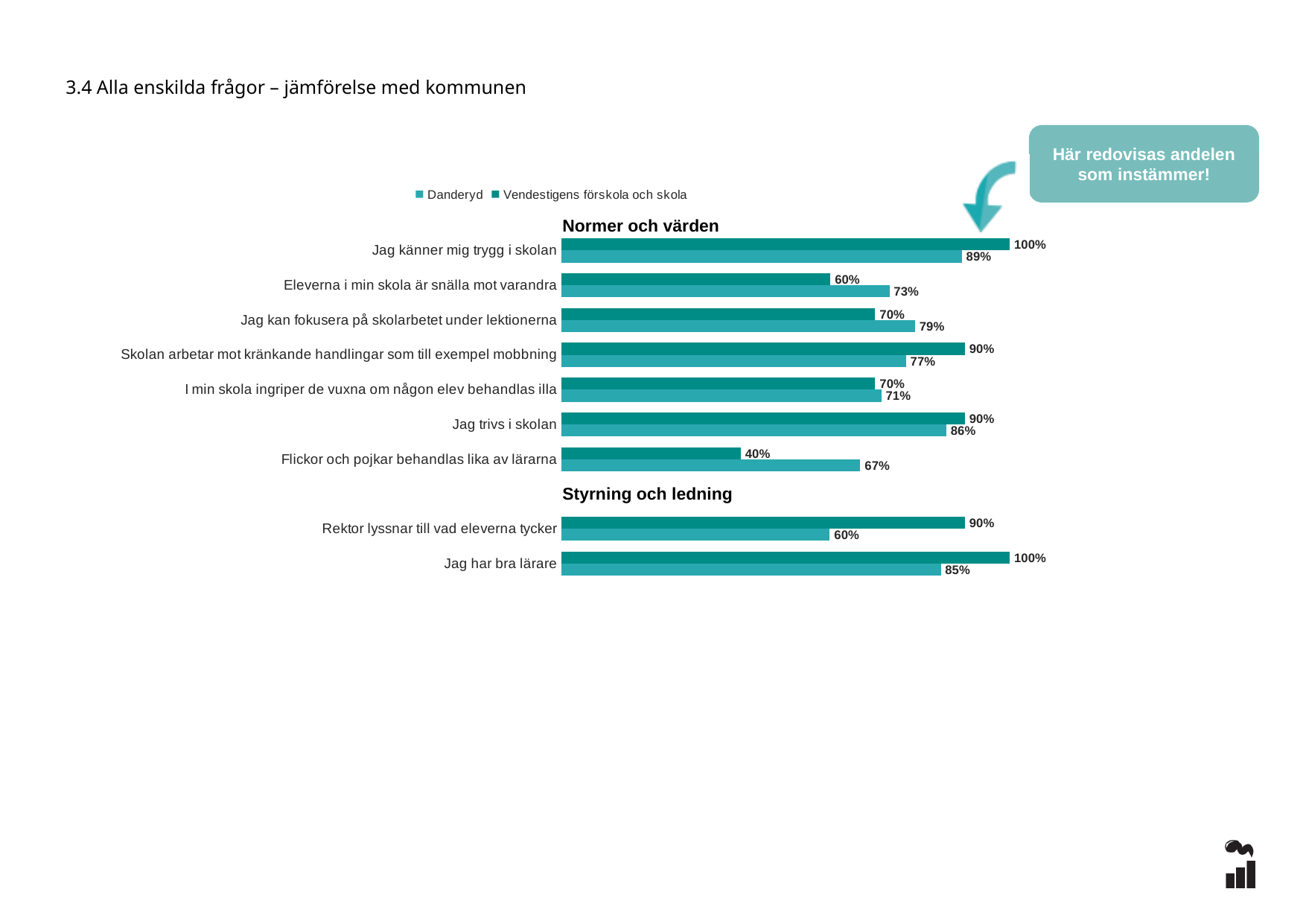
Which question has the lowest value for Vendestigens förskola och skola? Flickor och pojkar behandlas lika av lärarna What is the value for Vendestigens förskola och skola for "Jag känner mig trygg i skolan"? 100% What is the difference between Vendestigens förskola och skola and Danderyd for "Rektor lyssnar till vad eleverna tycker"? 30% What is the value for Danderyd for "Rektor lyssnar till vad eleverna tycker"? 60% What kind of chart is shown on the slide? bar chart How many series does the legend list? 2 How many questions are listed under the heading "Styrning och ledning"? 2 Which question has the highest value for Danderyd? Jag känner mig trygg i skolan For "Eleverna i min skola är snälla mot varandra", which is larger: Danderyd or Vendestigens förskola och skola? Danderyd What is the value for Danderyd for "Jag trivs i skolan"? 86% What is the value for Danderyd for "Flickor och pojkar behandlas lika av lärarna"? 67% How many questions (categories) are plotted in the chart in total? 9